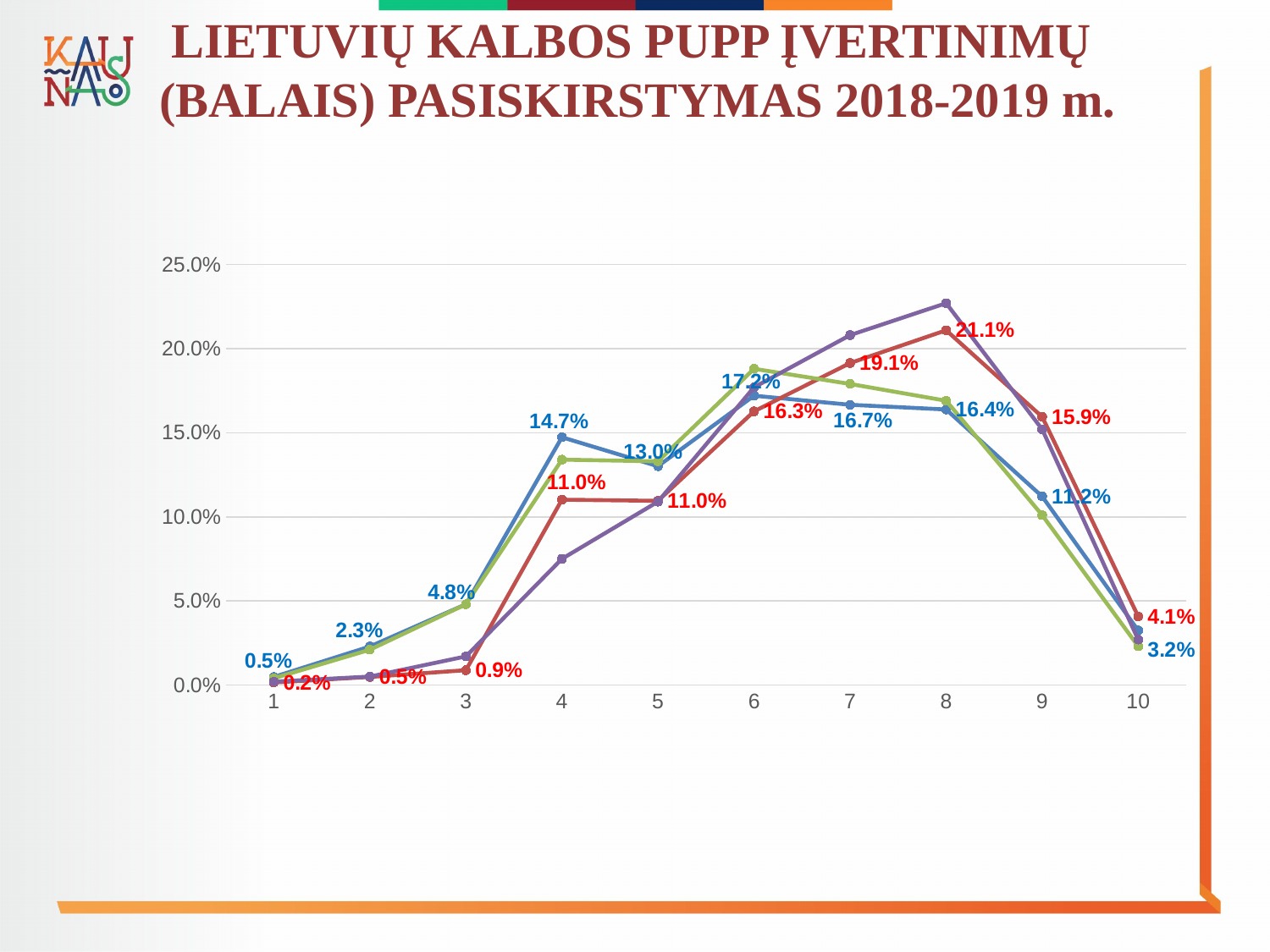
At which score does the red line reach its highest value? 8 How many score categories are shown on the x axis? 10 Is the value of the purple line at score 8 greater or less than 20.0%? greater What is the value of the red line at score 3? 0.9% What type of chart is shown on the slide? line chart What is the value of the blue line at score 4? 14.7% At score 4, which line has the larger value, the blue line or the red line? blue line At which score does the blue line reach its highest value? 6 What is the value of the blue line at score 10? 3.2% What is the value of the red line at score 8? 21.1% At which score does the red line have its lowest value? 1 What is the difference between the red line's values at score 8 and score 7? 2.0%